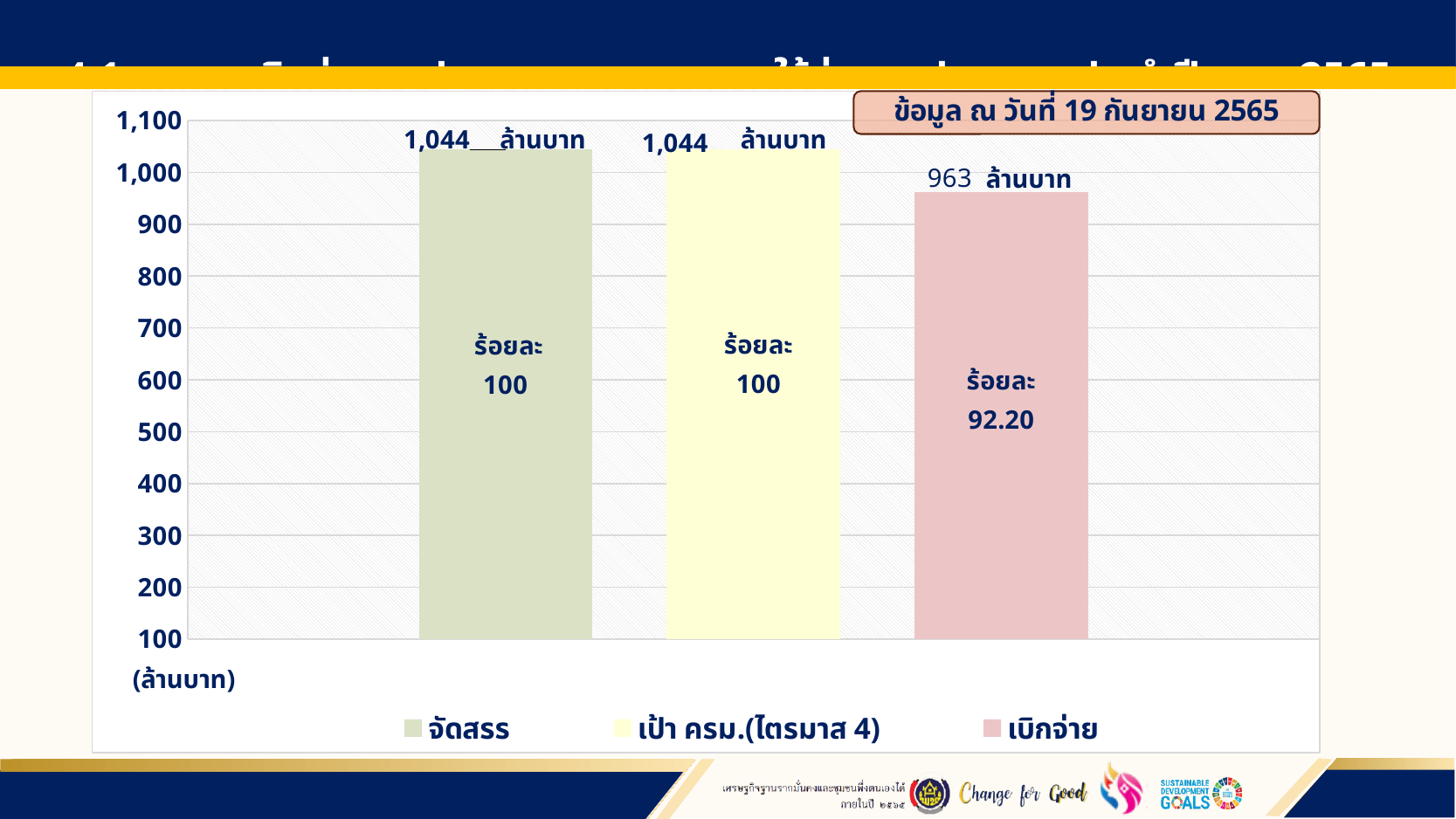
What kind of chart is shown on the slide? bar chart Which bar has the lowest value? เบิกจ่าย Is the value for เบิกจ่าย greater or less than 1,000? less What percentage (ร้อยละ) is shown on the เบิกจ่าย bar? 92.20 How many series does the legend list? 3 What is the difference between the จัดสรร value and the เบิกจ่าย value? 81 ล้านบาท How many bars are plotted in the chart? 3 What is the value for จัดสรร? 1,044 ล้านบาท Which is larger, the value for เป้า ครม.(ไตรมาส 4) or the value for เบิกจ่าย? เป้า ครม.(ไตรมาส 4) What date is the data on the slide stated to be as of? 19 กันยายน 2565 What is the value for เบิกจ่าย? 963 ล้านบาท What is the value for เป้า ครม.(ไตรมาส 4)? 1,044 ล้านบาท